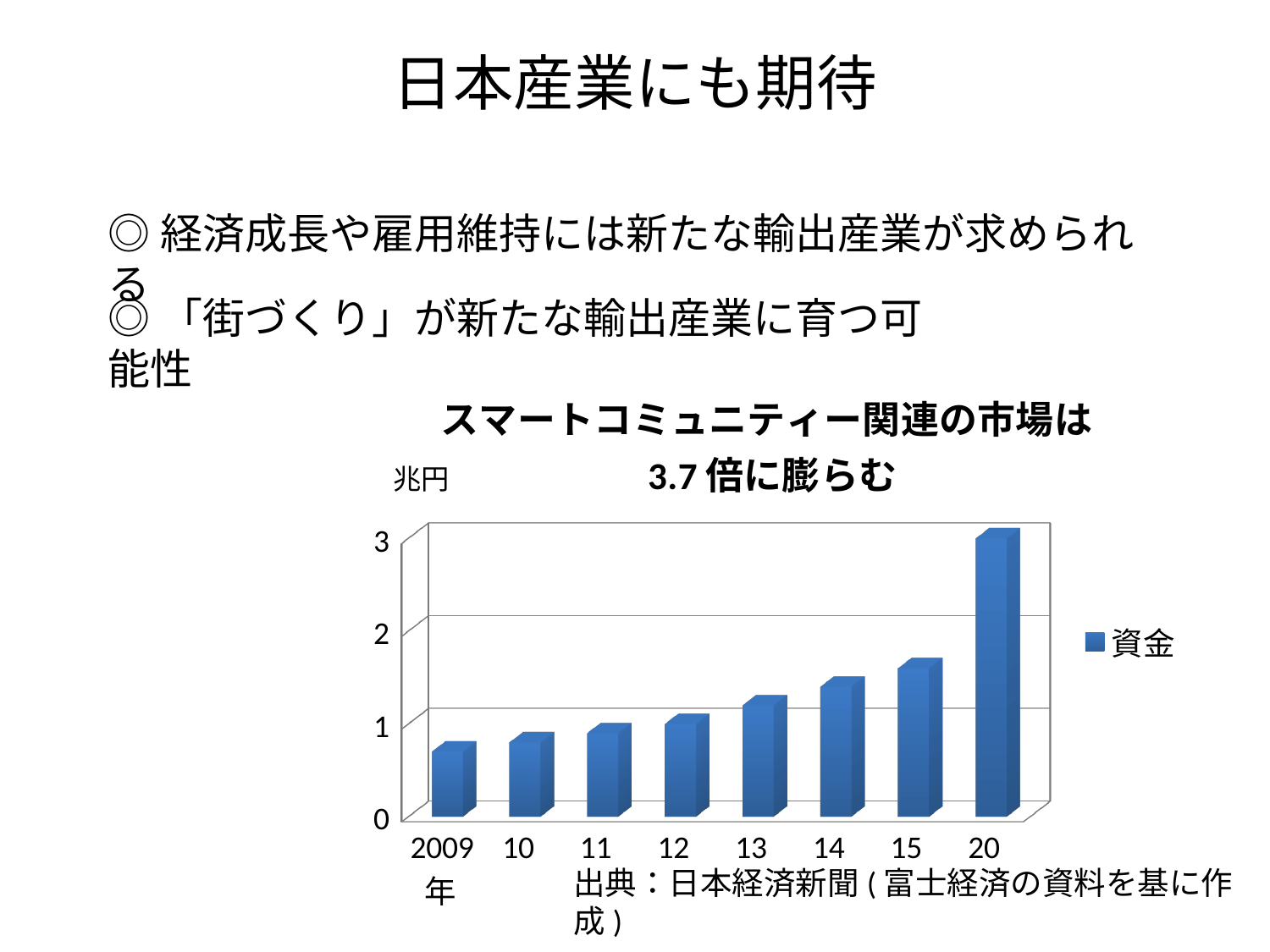
Is the value for 20 greater or less than 2? greater Which year has the highest bar on the chart? 20 How many bars (categories) are plotted on the chart? 8 Do the values rise or fall from 2009 to 20 along the x axis? rise How many series does the chart legend list? 1 What unit is shown on the vertical axis of the chart? 兆円 What kind of chart is shown on the slide? bar chart What is the name of the series shown in the legend? 資金 Which year has the lowest bar on the chart? 2009 Is the value for 15 greater or less than 1? greater Which is larger, the value for 14 or the value for 20? 20 Is the value for 2009 greater or less than 1? less